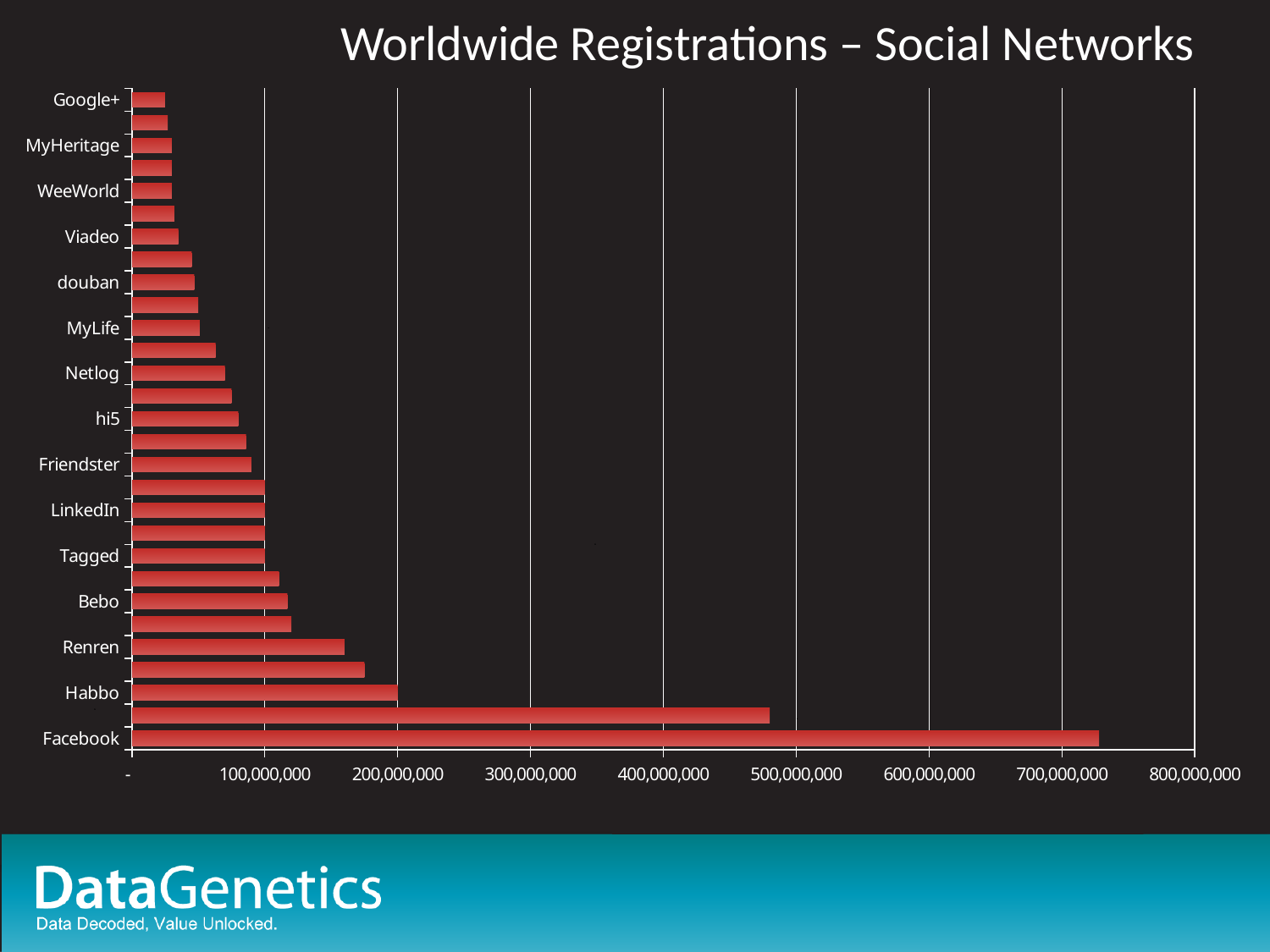
Which labelled social network has the lowest number of worldwide registrations? Google+ What is the title of the chart? Worldwide Registrations – Social Networks Is the value for Friendster greater or less than 100,000,000? less Is the value for Renren greater or less than 100,000,000? greater Is the value for Facebook greater or less than 700,000,000? greater Do the bar values increase or decrease going from the top of the chart to the bottom? increase Which has more worldwide registrations, Netlog or Renren? Renren What kind of chart is shown on the slide? bar chart Which social network has the highest number of worldwide registrations? Facebook Which has more worldwide registrations, Habbo or Facebook? Facebook